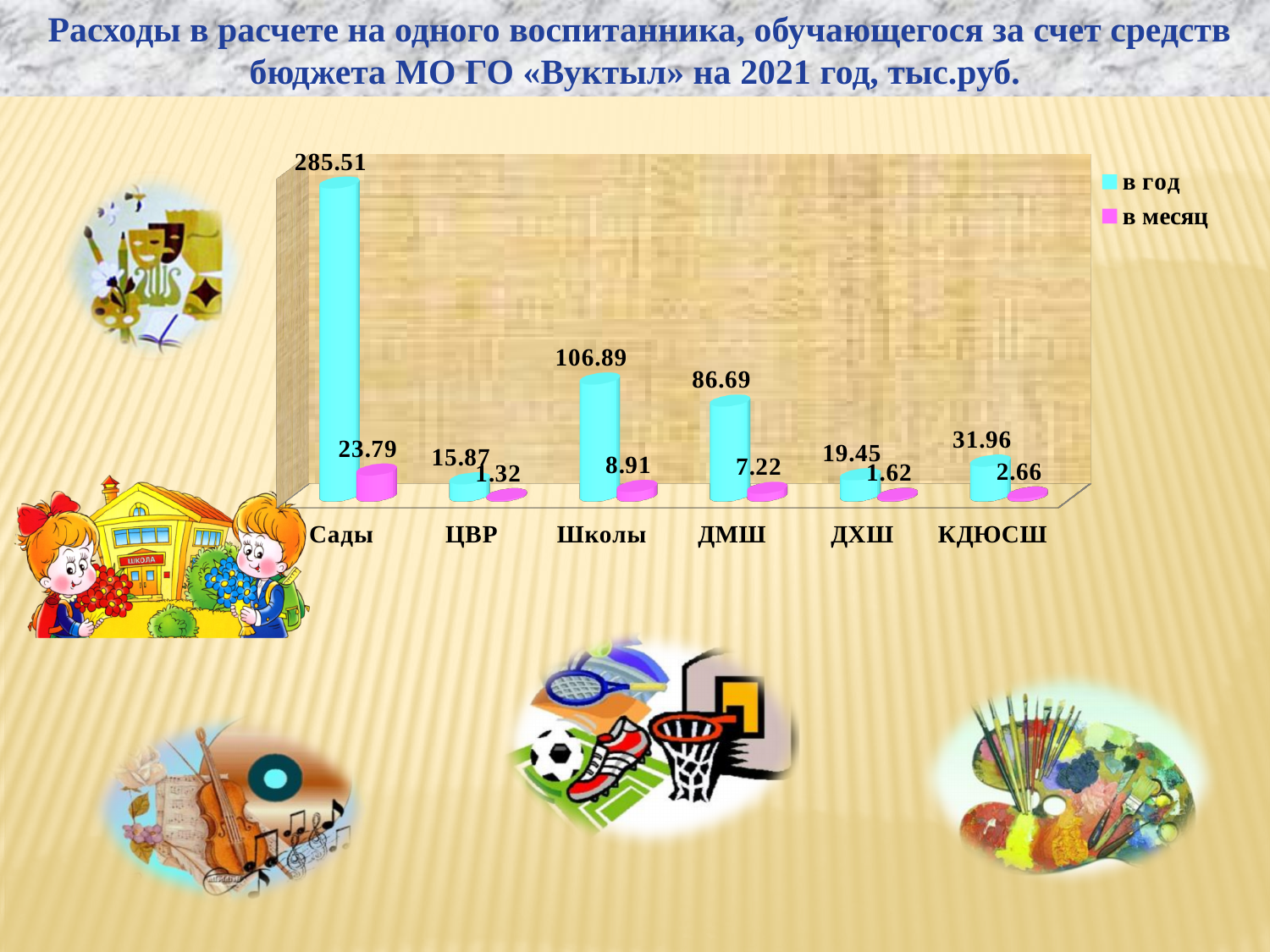
What is the value for ДМШ in the series «в год»? 86.69 How many series does the legend list? 2 Which colour represents the series «в месяц» in the legend? Pink What is the difference between the «в год» values for Школы and ДМШ? 20.20 What is the value for КДЮСШ in the series «в месяц»? 2.66 What kind of chart is shown on the slide? Bar chart Which category has the lowest value in the series «в месяц»? ЦВР How many categories are shown on the x axis? 6 Which is larger in the series «в год»: ДХШ or КДЮСШ? КДЮСШ Which category has the highest value in the series «в год»? Сады What is the value for Школы in the series «в месяц»? 8.91 What is the value for Сады in the series «в год»? 285.51